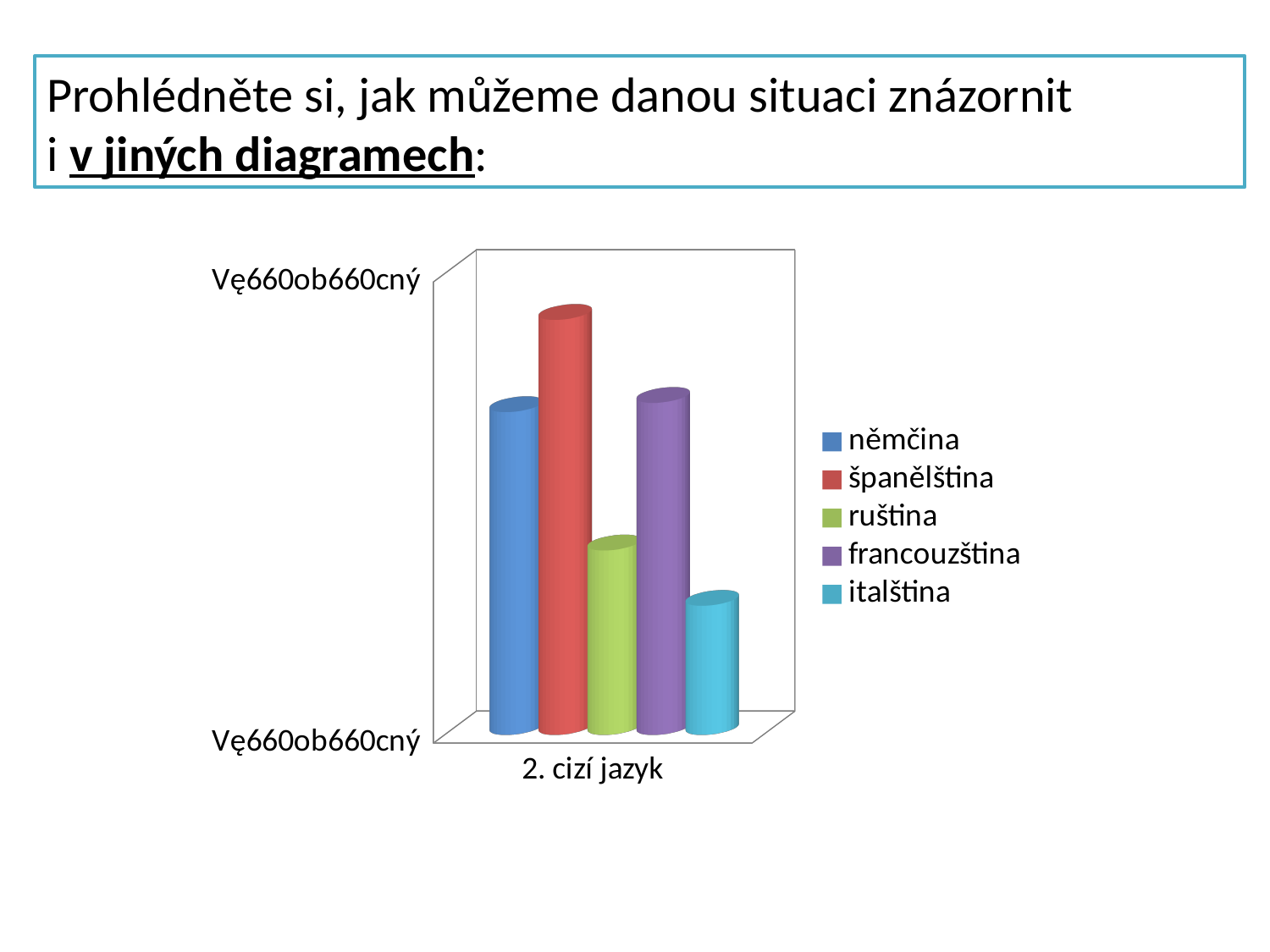
What kind of chart is shown on the slide? bar chart How many series does the legend list? 5 Which bar is taller, francouzština or italština? francouzština Which bar is taller, ruština or italština? ruština Which language has the shortest bar in the chart? italština What is the label shown under the horizontal axis of the chart? 2. cizí jazyk Which language has the tallest bar in the chart? španělština Which bar is taller, španělština or francouzština? španělština Which legend entry is shown in red? španělština How many bars are plotted in the chart? 5